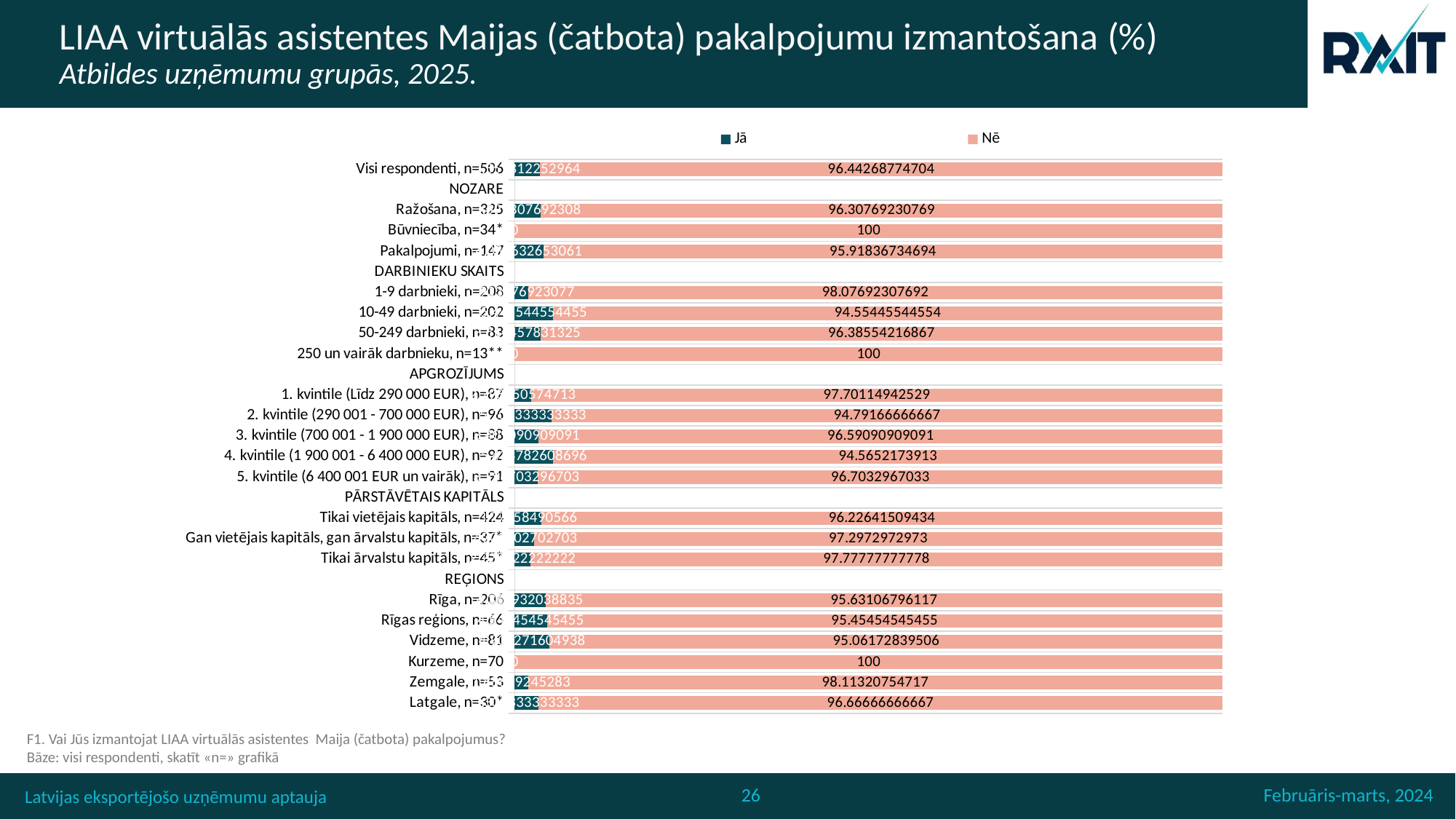
What kind of chart is shown on the slide? Stacked bar chart What are the two legend entries of the chart? Jā and Nē Among the REĢIONS categories, which has the lowest Nē value? Vidzeme, n=81 How many series does the legend list? 2 What is the Nē value for Zemgale, n=53? 98.11320754717 Among the REĢIONS categories, which has the highest Nē value? Kurzeme, n=70 What is the difference between the Nē values for Kurzeme, n=70 and Zemgale, n=53? 1.88679245283 What is the Nē value for 2. kvintile (290 001 - 700 000 EUR), n=96? 94.79166666667 What is the Nē value for Būvniecība, n=34*? 100 What is the Nē value for Visi respondenti, n=506? 96.44268774704 What is the Nē value for 10-49 darbnieki, n=202? 94.55445544554 Which has a larger Nē value: 1-9 darbnieki, n=208 or 10-49 darbnieki, n=202? 1-9 darbnieki, n=208